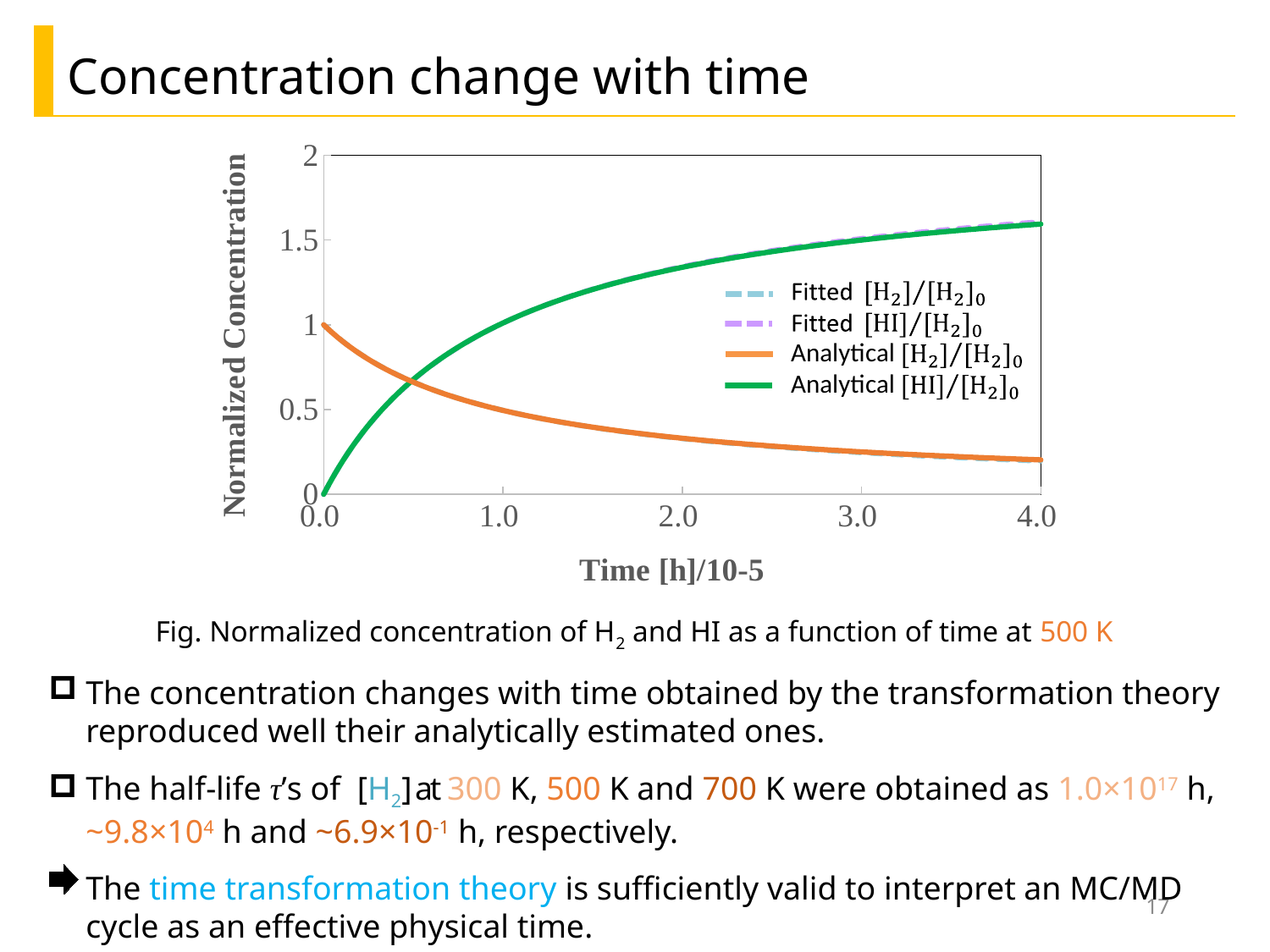
Is the value of Analytical [HI]/[H2]0 at time 4.0 greater or less than 1.5? greater At time 4.0, which is larger: Analytical [H2]/[H2]0 or Analytical [HI]/[H2]0? Analytical [HI]/[H2]0 What kind of chart is shown on the slide? line chart Does the Analytical [HI]/[H2]0 curve rise or fall as time increases? rise Is the value of Analytical [H2]/[H2]0 at time 4.0 greater or less than 0.5? less What is the value of Analytical [H2]/[H2]0 at time 0.0? 1 What is the label of the y axis of the chart? Normalized Concentration Is the value of Analytical [H2]/[H2]0 at time 2.0 greater or less than 0.5? less What is the value of Analytical [HI]/[H2]0 at time 0.0? 0 What is the label of the x axis of the chart? Time [h]/10-5 How many series does the legend of the chart list? 4 Does the Analytical [H2]/[H2]0 curve rise or fall as time increases? fall